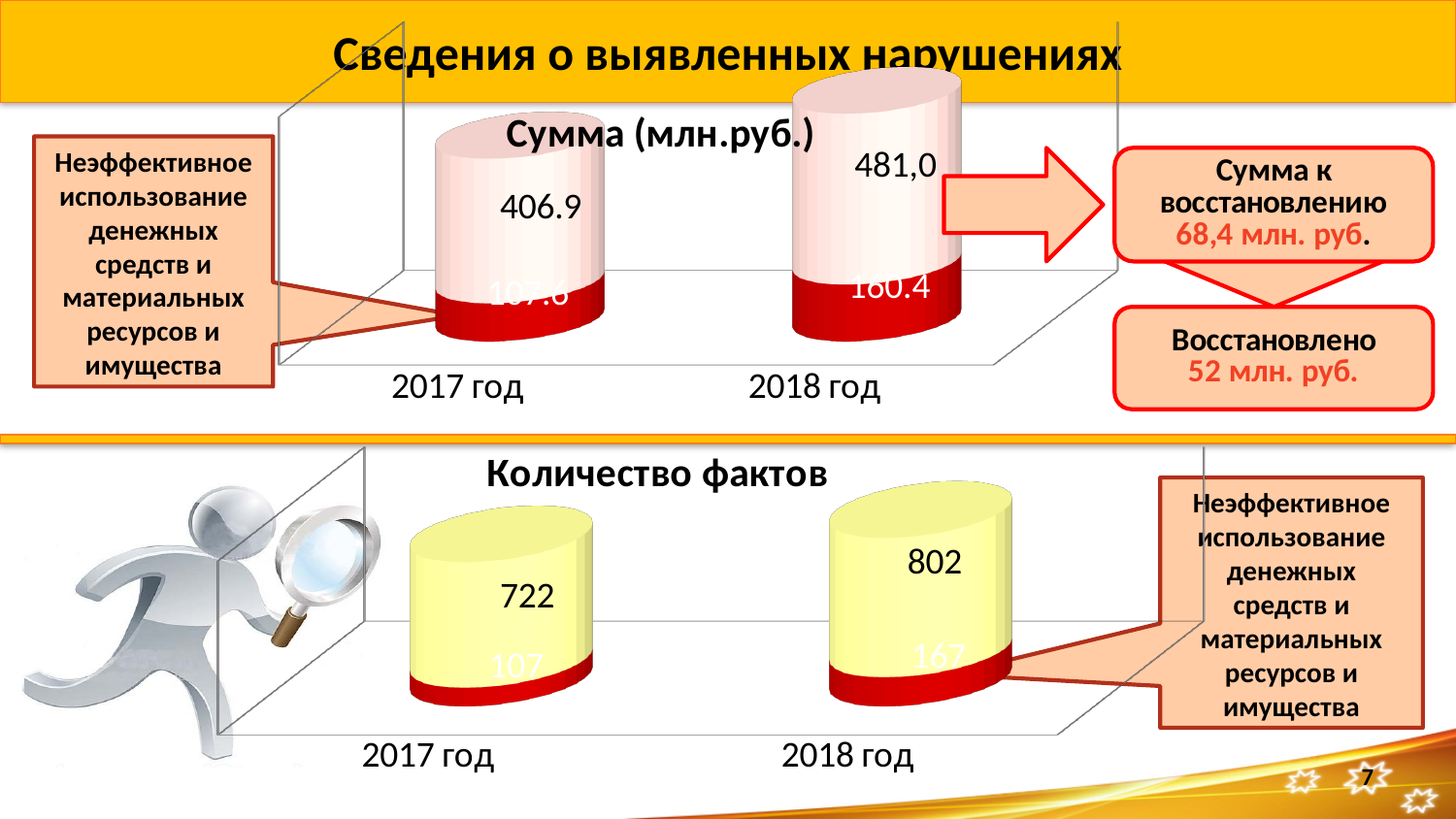
On the chart titled "Количество фактов", what is the value printed on the upper (yellow) segment for 2017 год? 722 On the chart titled "Количество фактов", what is the value printed on the upper (yellow) segment for 2018 год? 802 On the chart titled "Сумма (млн.руб.)", what is the value printed on the upper (pink) segment for 2018 год? 481,0 How many year categories are shown on the chart titled "Сумма (млн.руб.)"? 2 What is the title of the lower chart on the slide? Количество фактов On the chart titled "Сумма (млн.руб.)", do the upper-segment values rise or fall from 2017 год to 2018 год? Rise What kind of chart is the one titled "Количество фактов"? Bar chart On the chart titled "Количество фактов", what is the difference between the upper-segment values for 2018 год and 2017 год? 80 On the chart titled "Сумма (млн.руб.)", which year has the larger upper-segment value, 2017 год or 2018 год? 2018 год On the chart titled "Количество фактов", which year has the higher upper-segment value? 2018 год On the chart titled "Сумма (млн.руб.)", what is the value printed on the upper (pink) segment for 2017 год? 406.9 On the chart titled "Сумма (млн.руб.)", by how much does the upper-segment value for 2018 год exceed that for 2017 год? 74.1